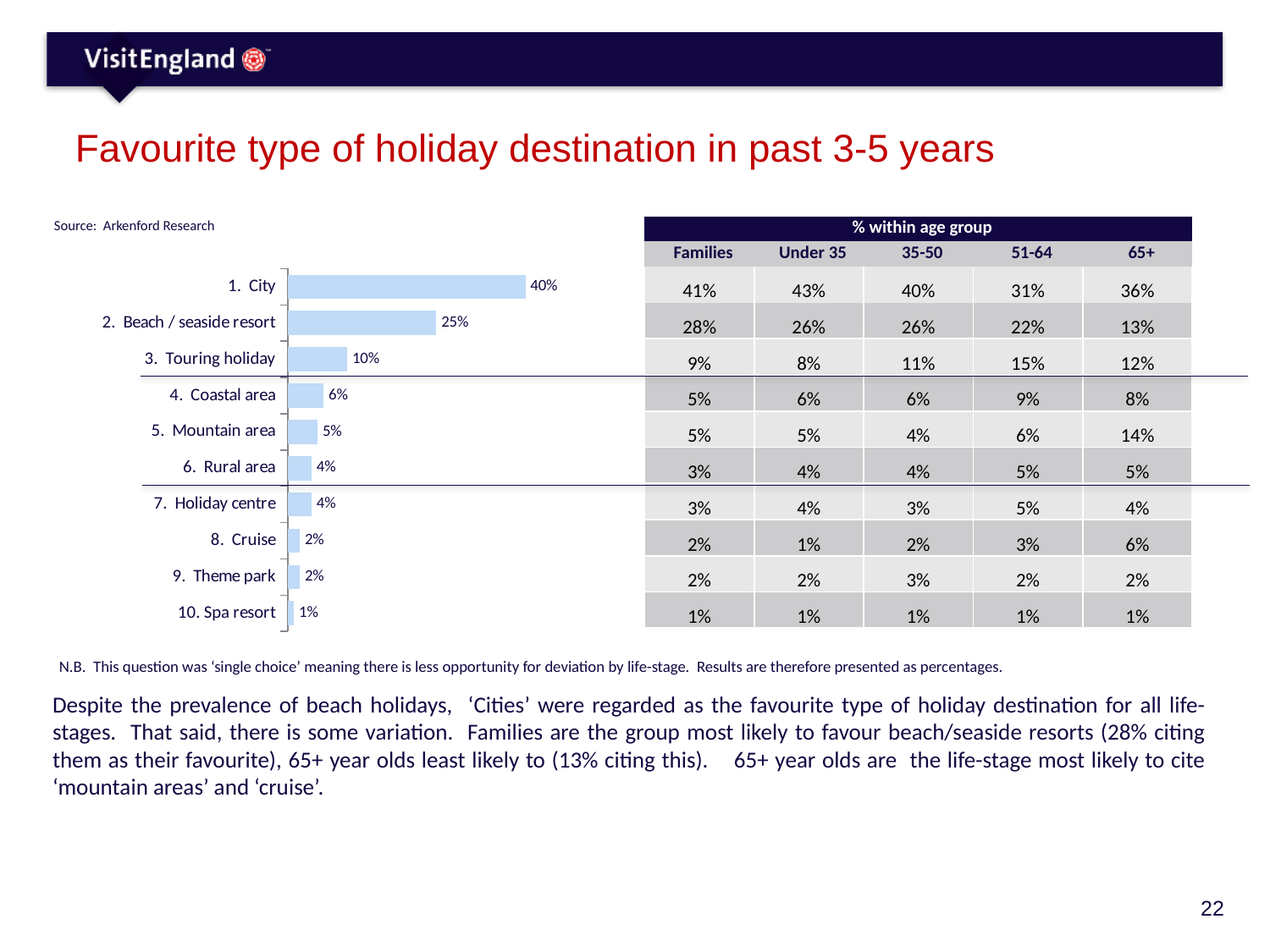
What is the title of the slide containing the bar chart? Favourite type of holiday destination in past 3-5 years Which is larger in the bar chart, the value for Coastal area or the value for Mountain area? Coastal area What is the value for Touring holiday in the bar chart? 10% Which category has the highest value in the bar chart? City What is the value for City in the bar chart? 40% Which category has the lowest value in the bar chart? Spa resort What kind of chart is shown on the slide? Bar chart What is the value for Beach / seaside resort in the bar chart? 25% What is the difference between the values for Touring holiday and Coastal area in the bar chart? 4% What is the difference between the values for City and Beach / seaside resort in the bar chart? 15% How many categories are shown in the bar chart? 10 What is the value for Spa resort in the bar chart? 1%